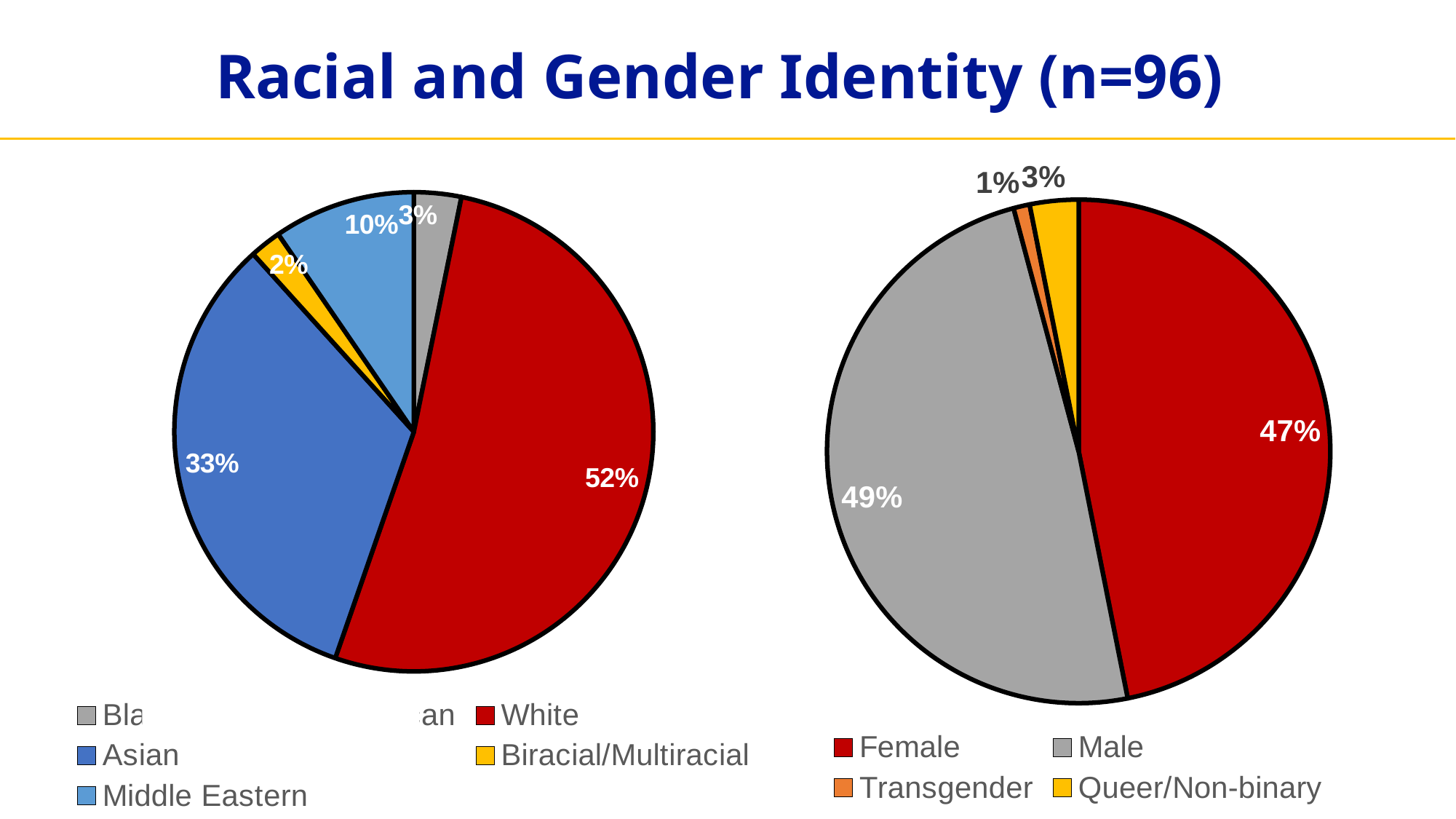
On the left pie chart, what percentage is shown for Asian? 33% On the left pie chart, what percentage is shown for Middle Eastern? 10% On the right pie chart, what percentage is shown for Queer/Non-binary? 3% On the right pie chart, which category has the smallest slice? Transgender On the right pie chart, what percentage is shown for Female? 47% On the right pie chart, what percentage is shown for Transgender? 1% What type of chart is used on the right side of the slide? Pie chart On the left pie chart, which category has the largest slice? White On the left pie chart, what is the difference in percentage points between White and Asian? 19 On the right pie chart, what percentage is shown for Male? 49% On the left pie chart, what percentage is shown for Biracial/Multiracial? 2% On the left pie chart, what percentage is shown for White? 52%